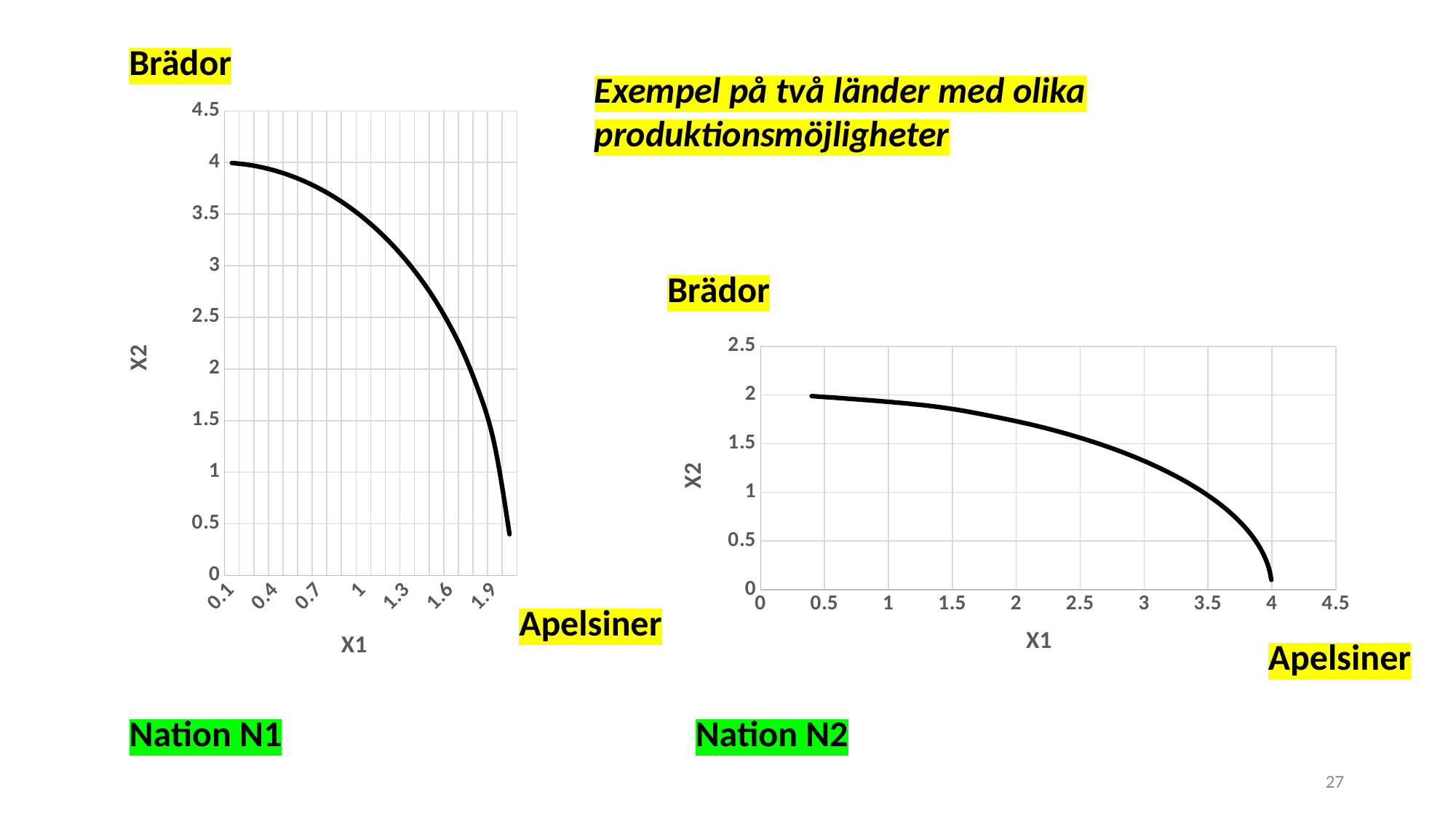
Which chart's curve reaches a higher maximum value of X2, the left chart (Nation N1) or the right chart (Nation N2)? the left chart (Nation N1) In the right chart (Nation N2), is the value of X2 at X1 = 3 greater or less than 1? greater In the left chart (Nation N1), do the values rise or fall as X1 increases? fall In the right chart (Nation N2), do the values rise or fall as X1 increases? fall What is the highest tick value shown on the vertical axis of the right chart (Nation N2)? 2.5 In the left chart (Nation N1), is the value of X2 at X1 = 1 greater or less than 3? greater In the left chart (Nation N1), is the value of X2 at X1 = 0.4 greater or less than 3.5? greater What is the title of the vertical axis in the left chart (Nation N1)? X2 What kind of chart is the left chart (Nation N1)? line chart What kind of chart is the right chart (Nation N2)? line chart